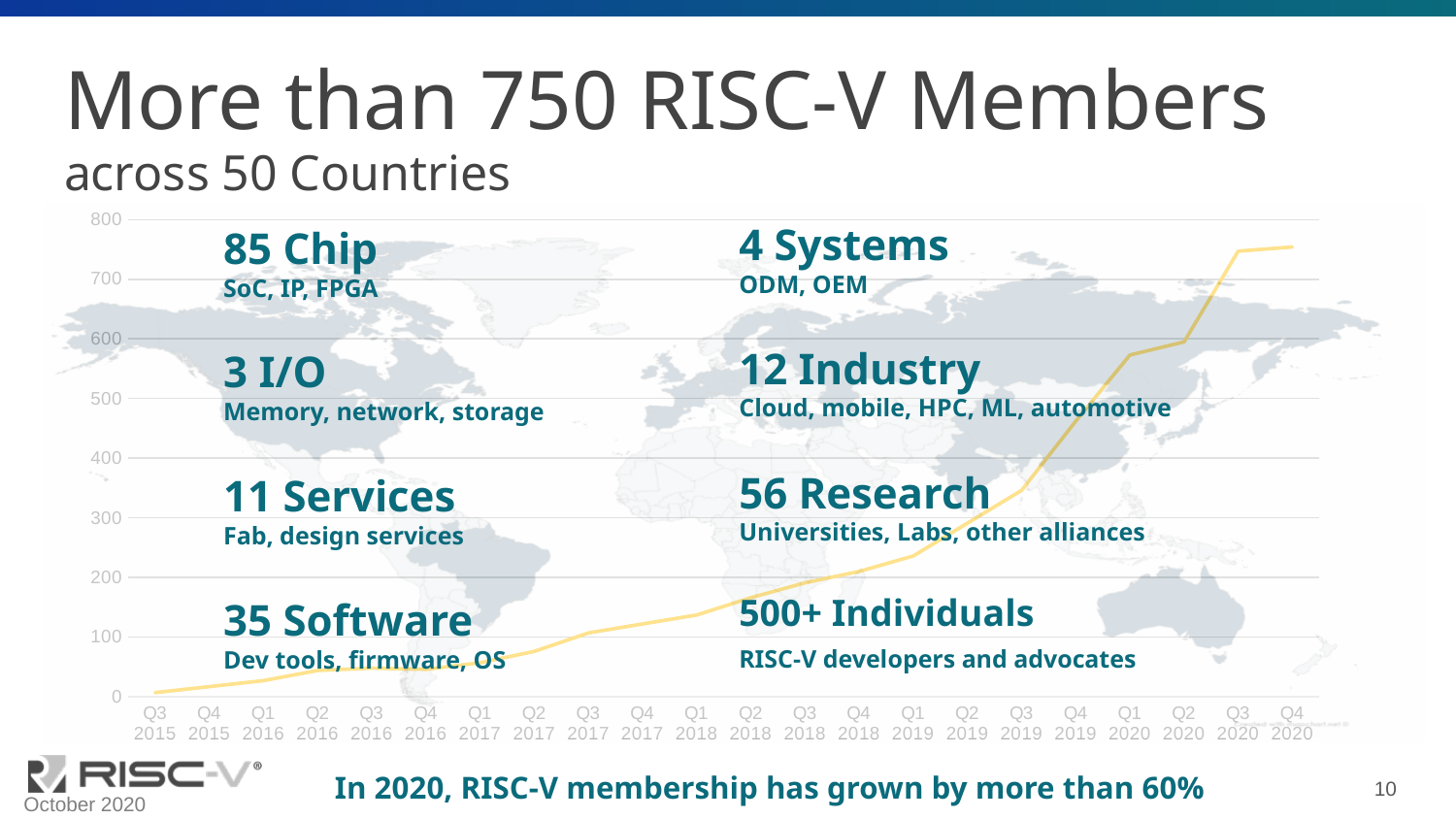
What kind of chart is shown in the background of the slide? line chart What colour is the plotted line on the chart? yellow Is the value for Q1 2017 greater or less than 200? less Is the value for Q4 2020 greater or less than 700? greater Is the value for Q2 2020 greater or less than 500? greater What is the highest tick value shown on the y axis of the chart? 800 Does the plotted line rise or fall from Q3 2015 to Q4 2020? rise Which quarter on the x axis has the lowest plotted value? Q3 2015 How many quarters are labelled along the x axis of the chart? 22 Which has the larger plotted value, Q1 2019 or Q1 2017? Q1 2019